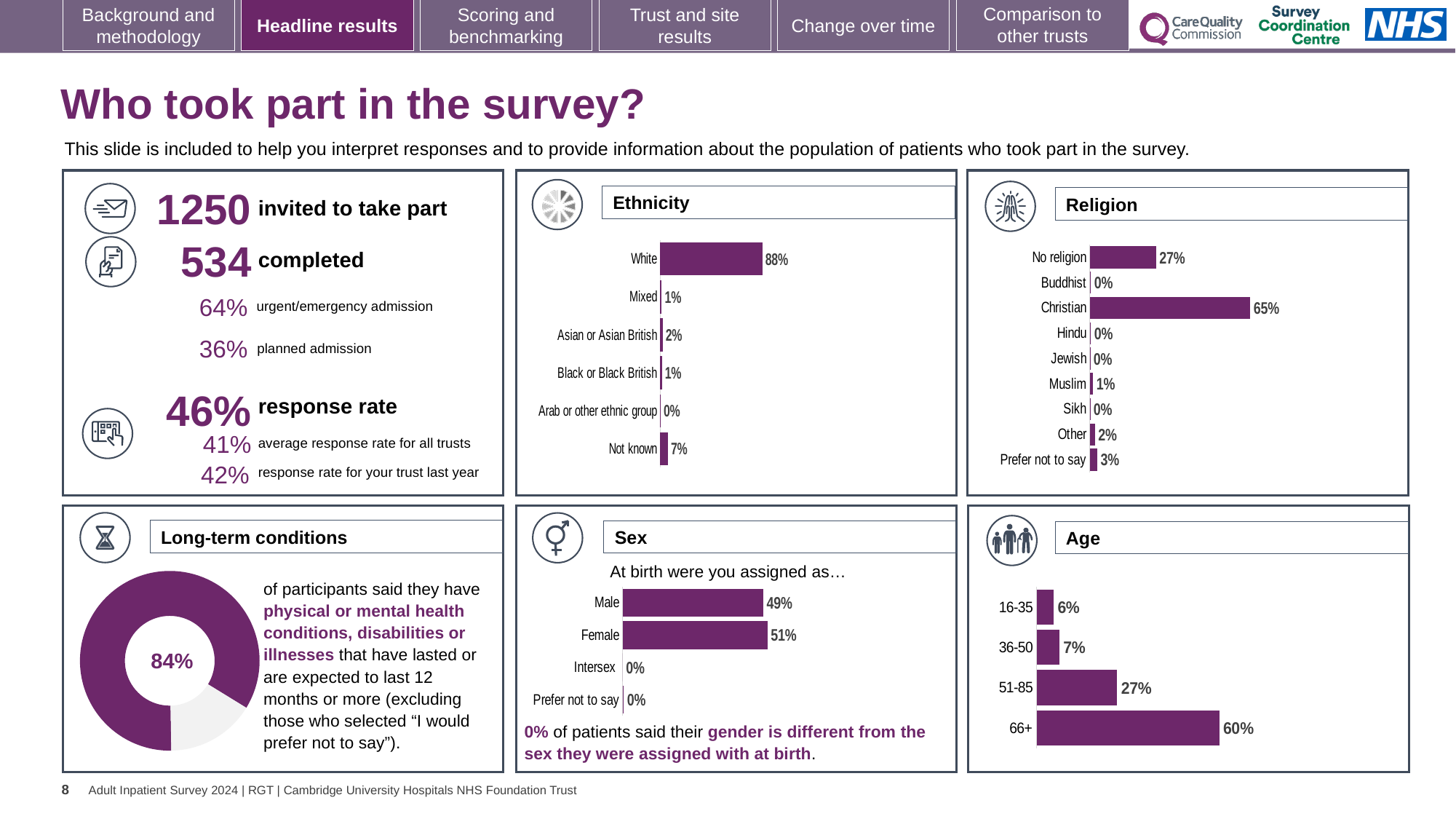
In the Sex chart, which is larger, Male or Female? Female In the Religion chart, which category has the highest value? Christian In the Sex chart, what percentage of respondents were Male? 49% In the Religion chart, what is the difference between Christian and No religion? 38% In the Long-term conditions chart, what share of participants said they have a long-term condition? 84% In the Ethnicity chart, what percentage of respondents were Not known? 7% In the Age chart, which age group has the lowest value? 16-35 In the Religion chart, how many categories are shown? 9 In the Age chart, do the values rise or fall as the age groups increase? rise In the Age chart, what percentage of respondents were aged 66+? 60% In the Religion chart, what percentage of respondents said No religion? 27% In the Ethnicity chart, what percentage of respondents were White? 88%